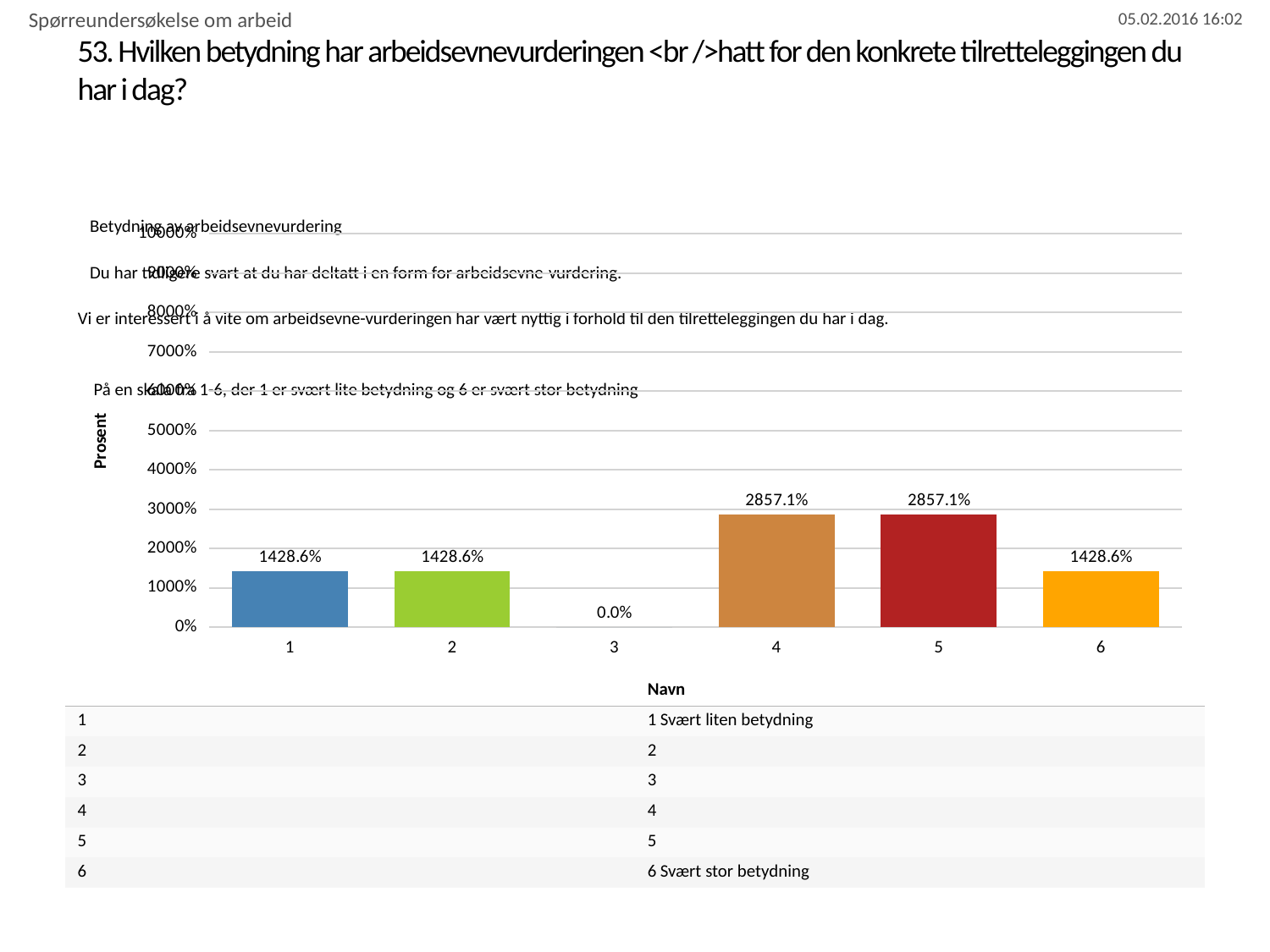
What is the value for category 6? 1428.6% Is the value for category 1 greater or less than 2000%? less What is the label of the y axis? Prosent What kind of chart is shown on the slide? bar chart Which category has the lowest value? 3 Which is larger, the value for category 2 or the value for category 4? 4 What is the difference between the values for category 5 and category 1? 1428.5% How many categories are shown on the x axis? 6 Is the value for category 5 greater or less than 2000%? greater What is the value for category 4? 2857.1% What is the value for category 3? 0.0%